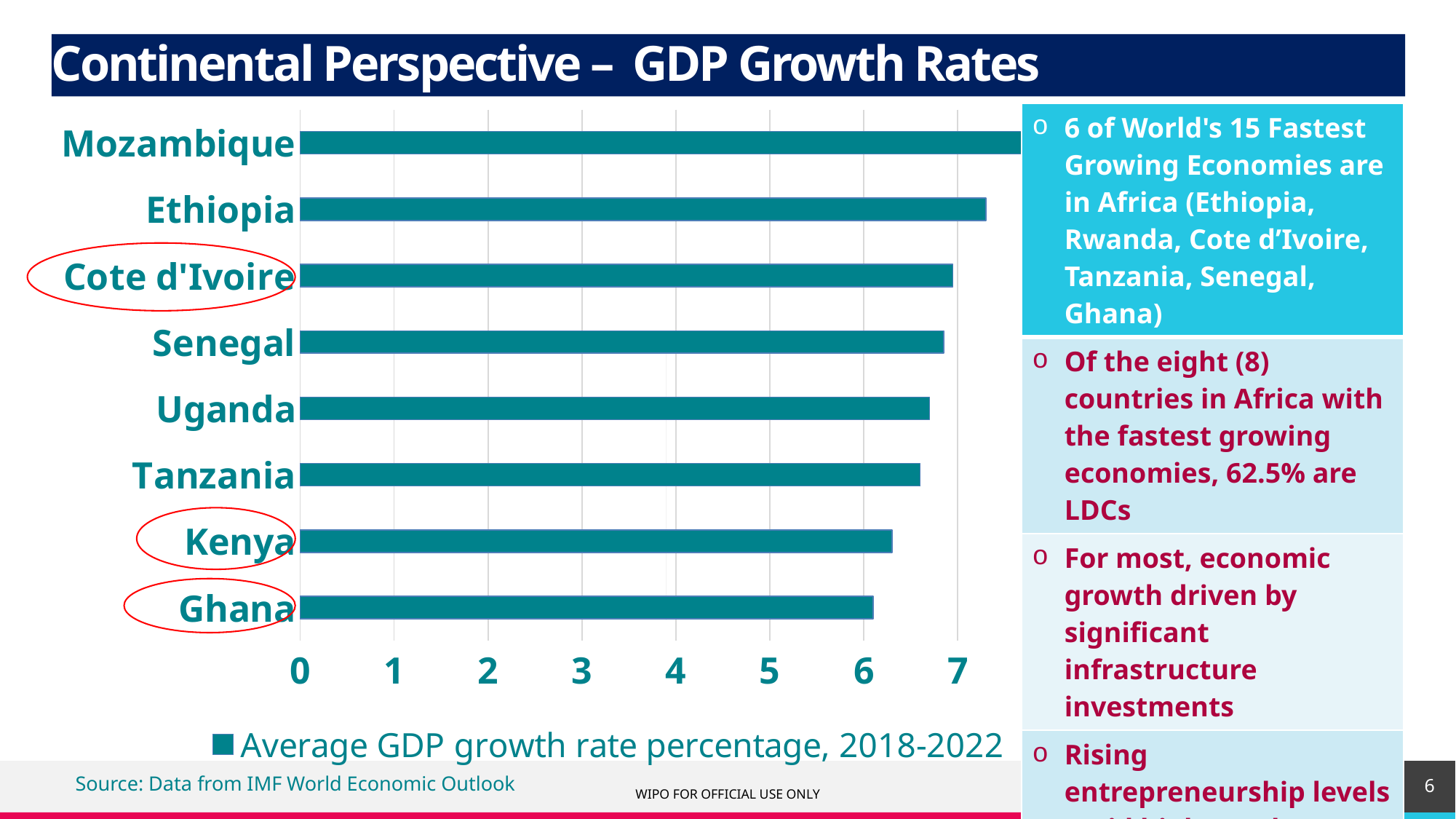
Which country has the lowest average GDP growth rate in the chart? Ghana Is the value for Ghana greater or less than 6? greater What series name does the legend show? Average GDP growth rate percentage, 2018-2022 How many countries are shown in the chart? 8 How many series does the legend list? 1 Which has a higher average GDP growth rate, Ethiopia or Kenya? Ethiopia Is the value for Mozambique greater or less than 7? greater Is the value for Tanzania greater or less than 7? less Which country has the highest average GDP growth rate in the chart? Mozambique Do the bar values rise or fall going from the top country to the bottom country? fall What kind of chart is shown on the slide? bar chart